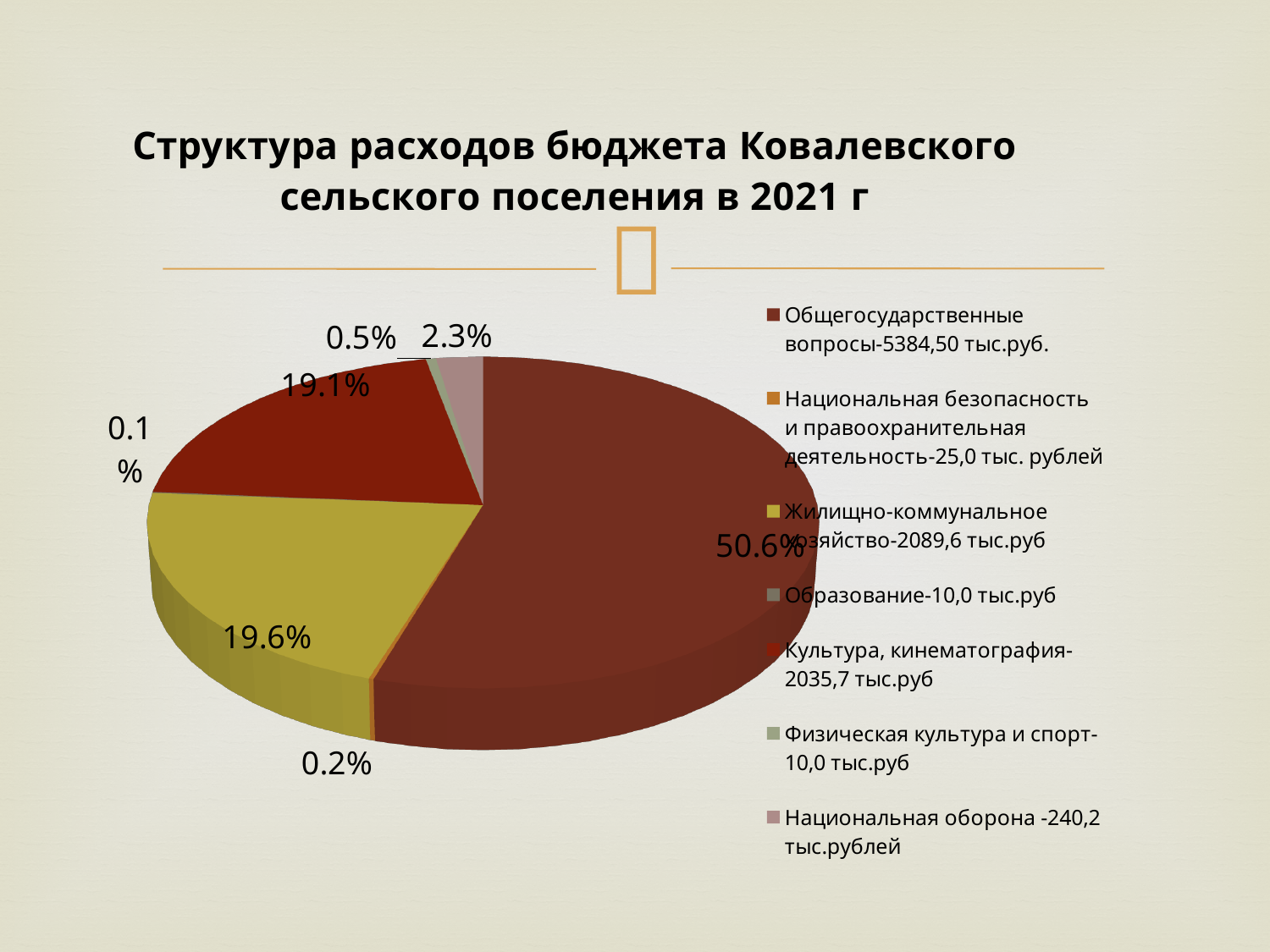
What is the title of the chart? Структура расходов бюджета Ковалевского сельского поселения в 2021 г Which category has the largest slice of the pie? Общегосударственные вопросы What share of the pie does Жилищно-коммунальное хозяйство take? 19.6% How many categories does the legend of the pie chart list? 7 Which slice is larger: Жилищно-коммунальное хозяйство or Культура, кинематография? Жилищно-коммунальное хозяйство What share of the pie does Культура, кинематография take? 19.1% What share of the pie does Национальная оборона take? 2.3% According to the legend, what amount in тыс.руб. is given for Общегосударственные вопросы? 5384,50 тыс.руб. What is the difference in percentage points between the Общегосударственные вопросы slice and the Жилищно-коммунальное хозяйство slice? 31.0 What kind of chart is shown on the slide? Pie chart